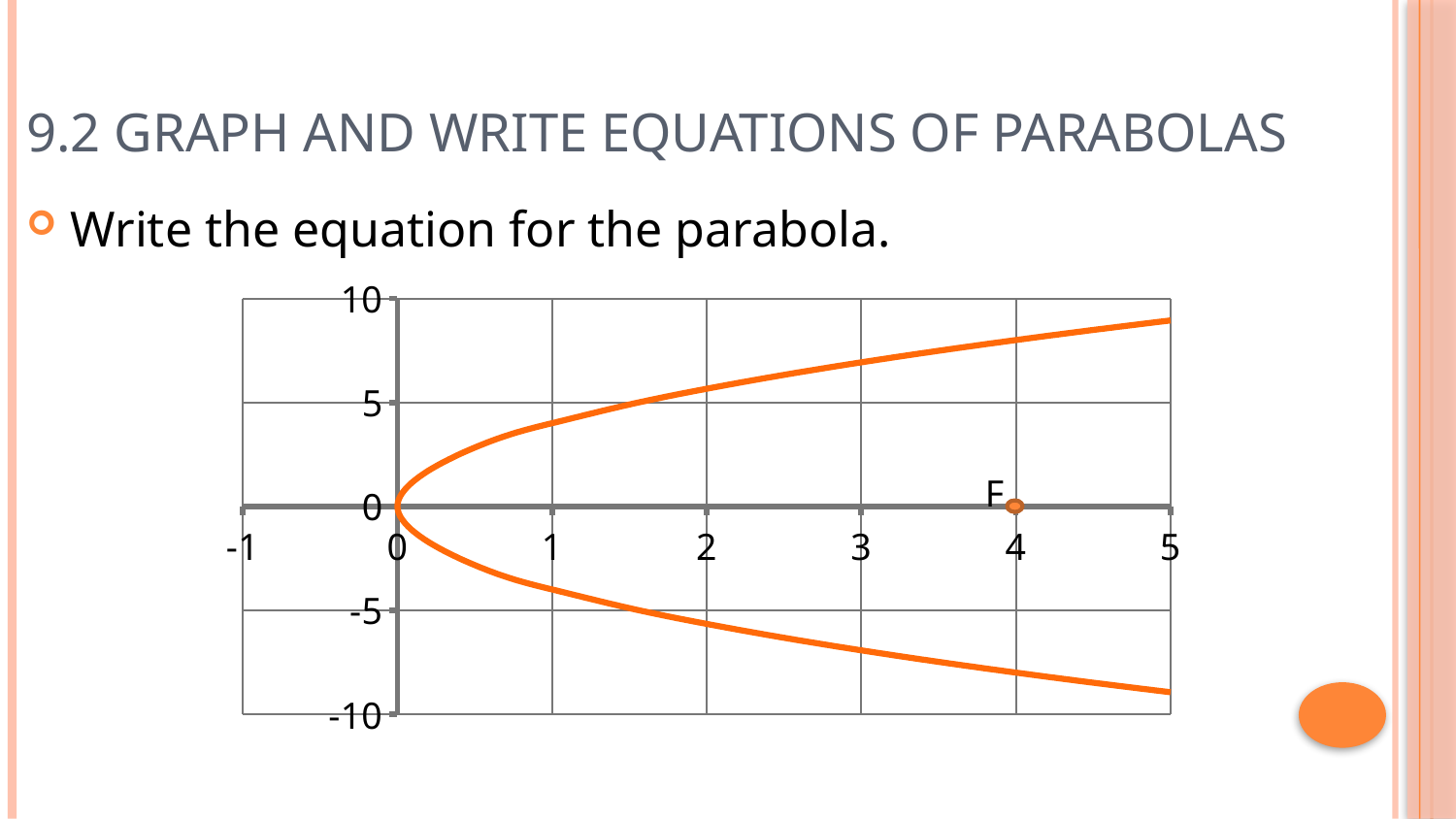
Is the value of the lower branch of the parabola at x = 1 greater or less than -5? greater What is the highest value shown on the vertical axis of the chart? 10 What is the x-coordinate of the point labeled F on the chart? 4 What is the lowest value shown on the horizontal axis of the chart? -1 What is the y-coordinate of the point labeled F on the chart? 0 Does the upper branch of the parabola rise or fall as x increases from 0 to 5? rise In which direction does the parabola on the chart open? to the right Is the value of the lower branch of the parabola at x = 5 greater or less than -5? less At what x value does the vertex of the parabola (where the two branches meet) lie? 0 Is the value of the upper branch of the parabola at x = 1 greater or less than 5? less Does the lower branch of the parabola rise or fall as x increases from 0 to 5? fall